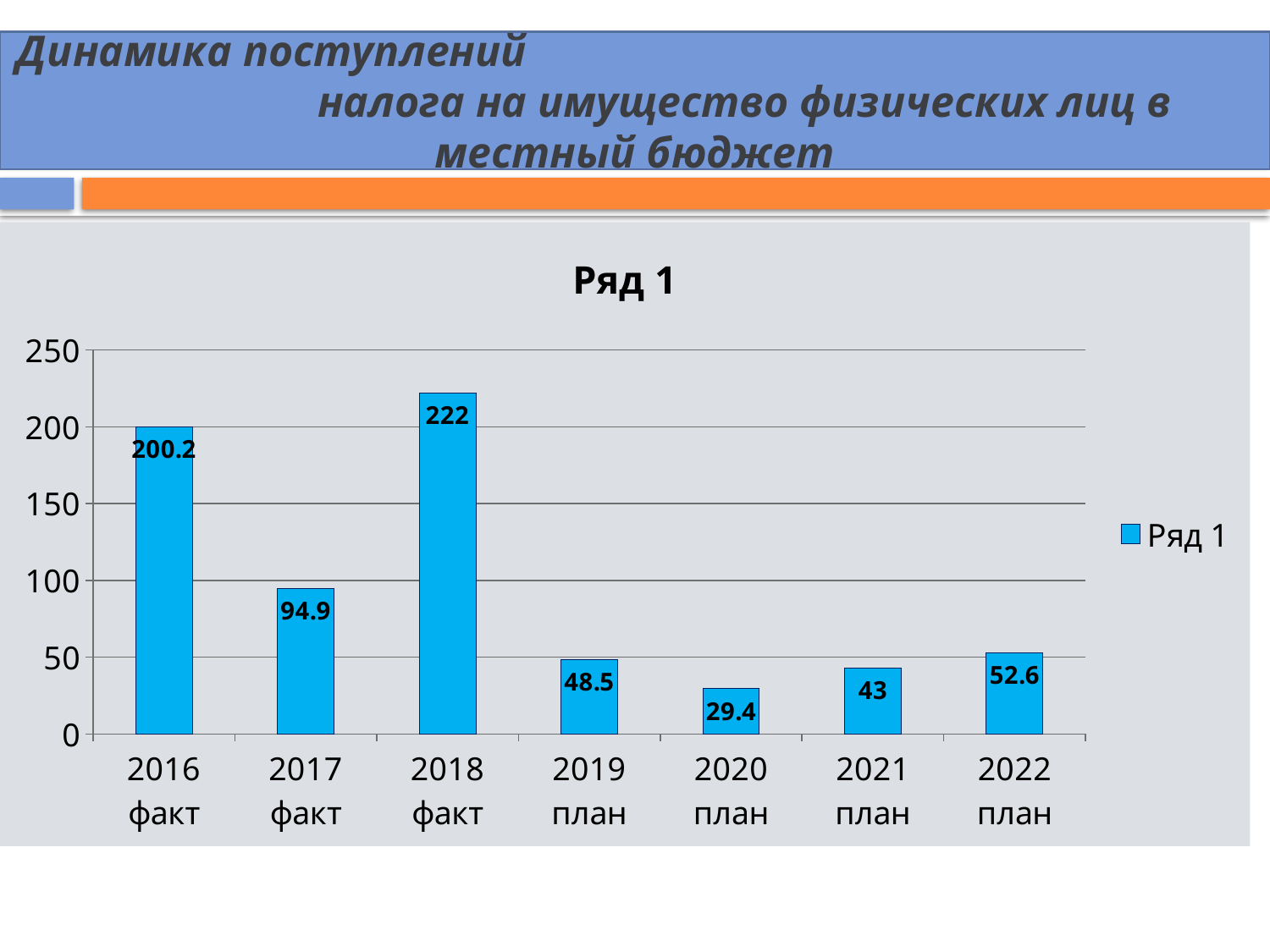
What is the value for 2016 факт? 200.2 How many categories are shown on the x axis? 7 What is the value for 2022 план? 52.6 What is the difference between the values for 2018 факт and 2017 факт? 127.1 What is the title of the chart? Ряд 1 Which category has the highest value? 2018 факт Is the value for 2017 факт greater or less than 100? less Which category has the lowest value? 2020 план Which is larger, the value for 2019 план or the value for 2021 план? 2019 план What is the difference between the values for 2022 план and 2021 план? 9.6 What kind of chart is shown on the slide? bar chart What is the value for 2020 план? 29.4